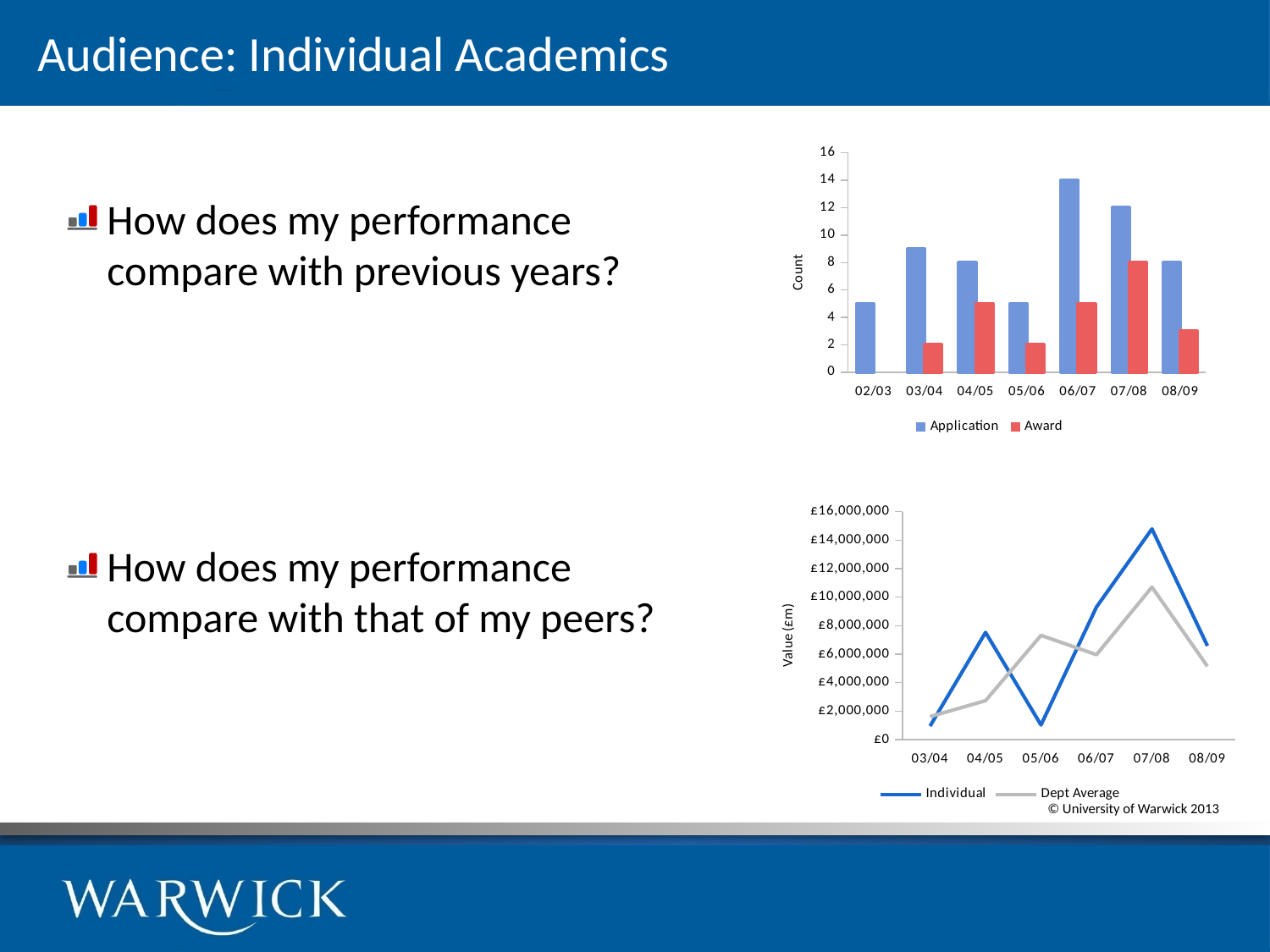
In the top bar chart, how many series does the legend list? 2 In the bottom line chart, which year has the highest Individual value? 07/08 In the top bar chart, how many year categories are shown on the x axis? 7 In the bottom line chart, which is larger in 05/06, the Individual value or the Dept Average value? Dept Average What type of chart is the bottom chart on the slide? line chart In the top bar chart, what is the Award count for 07/08? 8 In the top bar chart, which year has the highest Award count? 07/08 In the top bar chart, is the Application count for 03/04 greater or less than 8? greater In the bottom line chart, is the Individual value for 07/08 greater or less than £14,000,000? greater In the top bar chart, which year has the highest Application count? 06/07 In the top bar chart, what is the Application count for 06/07? 14 What type of chart is the top chart on the slide? bar chart